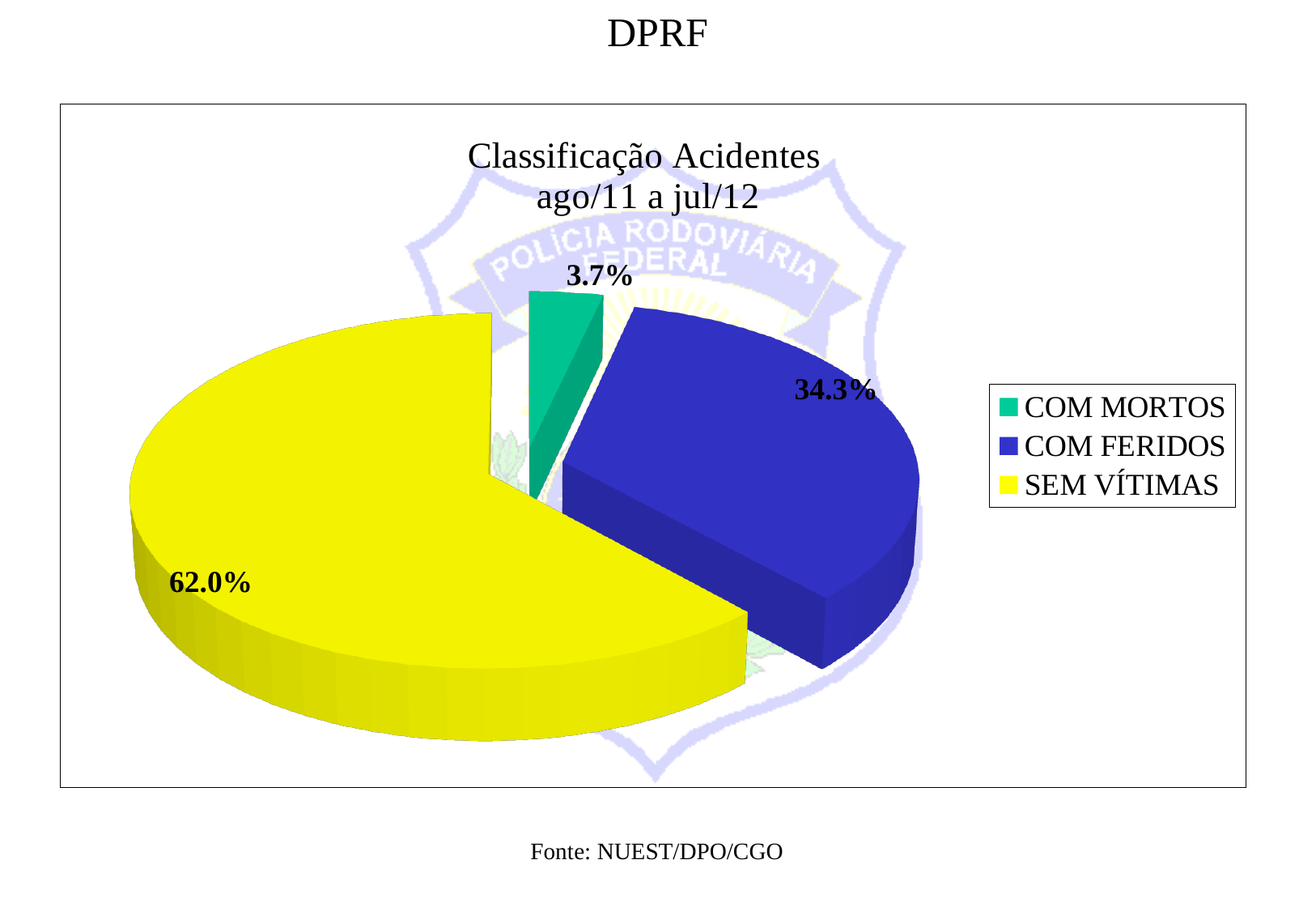
What share of the pie is COM MORTOS? 3.7% What kind of chart is shown on the slide? pie chart How many categories does the pie chart have? 3 Which is larger, COM FERIDOS or COM MORTOS? COM FERIDOS What share of the pie is SEM VÍTIMAS? 62.0% What colour is the SEM VÍTIMAS slice? yellow What share of the pie is COM FERIDOS? 34.3% What is the title of the chart? Classificação Acidentes ago/11 a jul/12 Which category has the largest slice? SEM VÍTIMAS What is the difference between the SEM VÍTIMAS and COM FERIDOS shares? 27.7% What is the difference between the COM FERIDOS and COM MORTOS shares? 30.6% Which category has the smallest slice? COM MORTOS